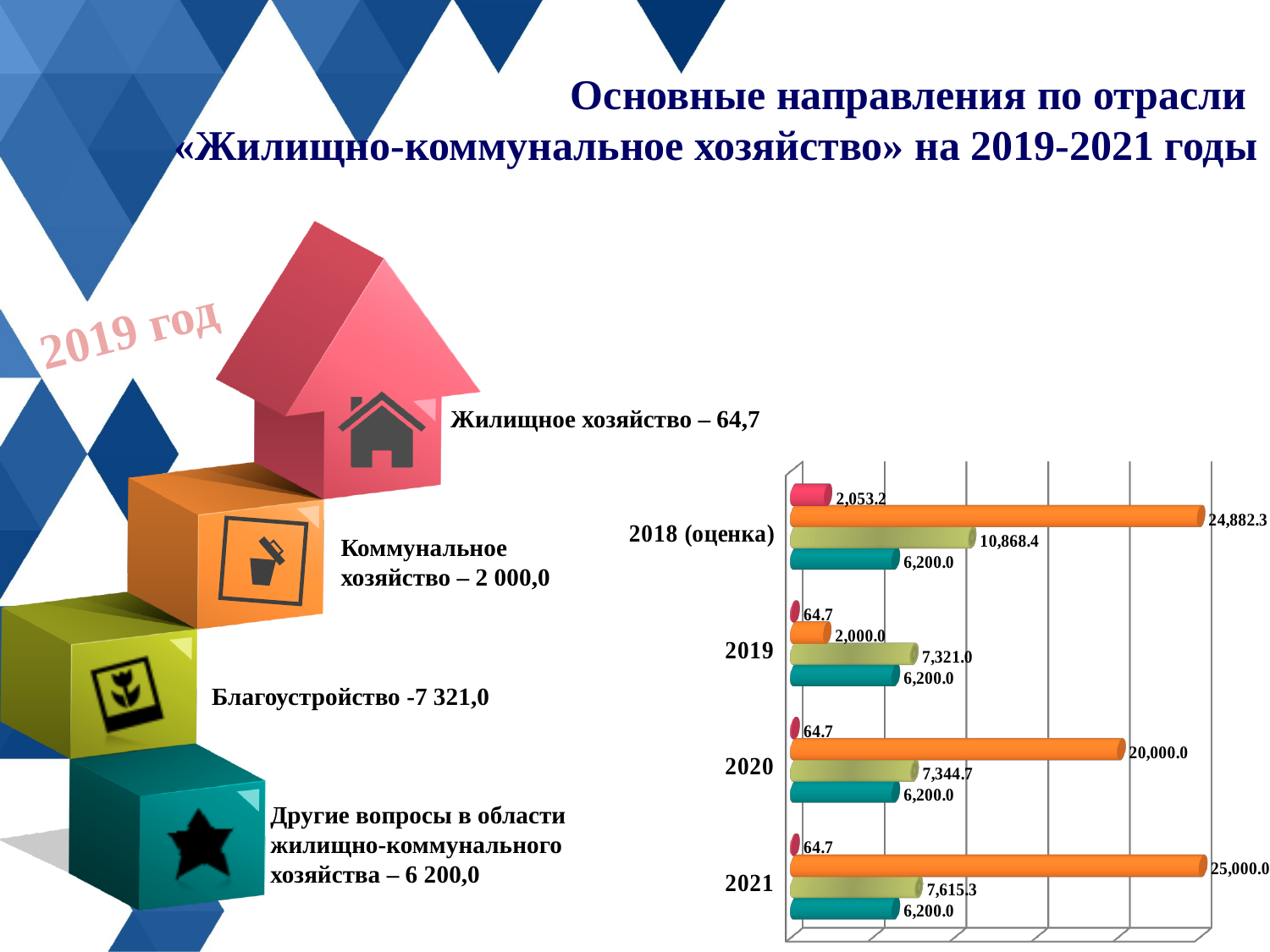
What is the difference between the yellow-green bar values for 2018 (оценка) and 2019? 3,547.4 What is the value of the yellow-green bar for 2019? 7,321.0 In which year category is the orange bar the shortest? 2019 What is the value of the teal bar for 2021? 6,200.0 What is the value of the orange bar for 2020? 20,000.0 What is the value of the pink bar for 2018 (оценка)? 2,053.2 What is the difference between the orange bar values for 2021 and 2020? 5,000.0 Which is larger for 2019: the yellow-green bar or the teal bar? the yellow-green bar In which year category is the orange bar the longest? 2021 How many year categories does the bar chart show? 4 What is the value of the orange bar for 2018 (оценка)? 24,882.3 What kind of chart is shown on the right side of the slide? bar chart